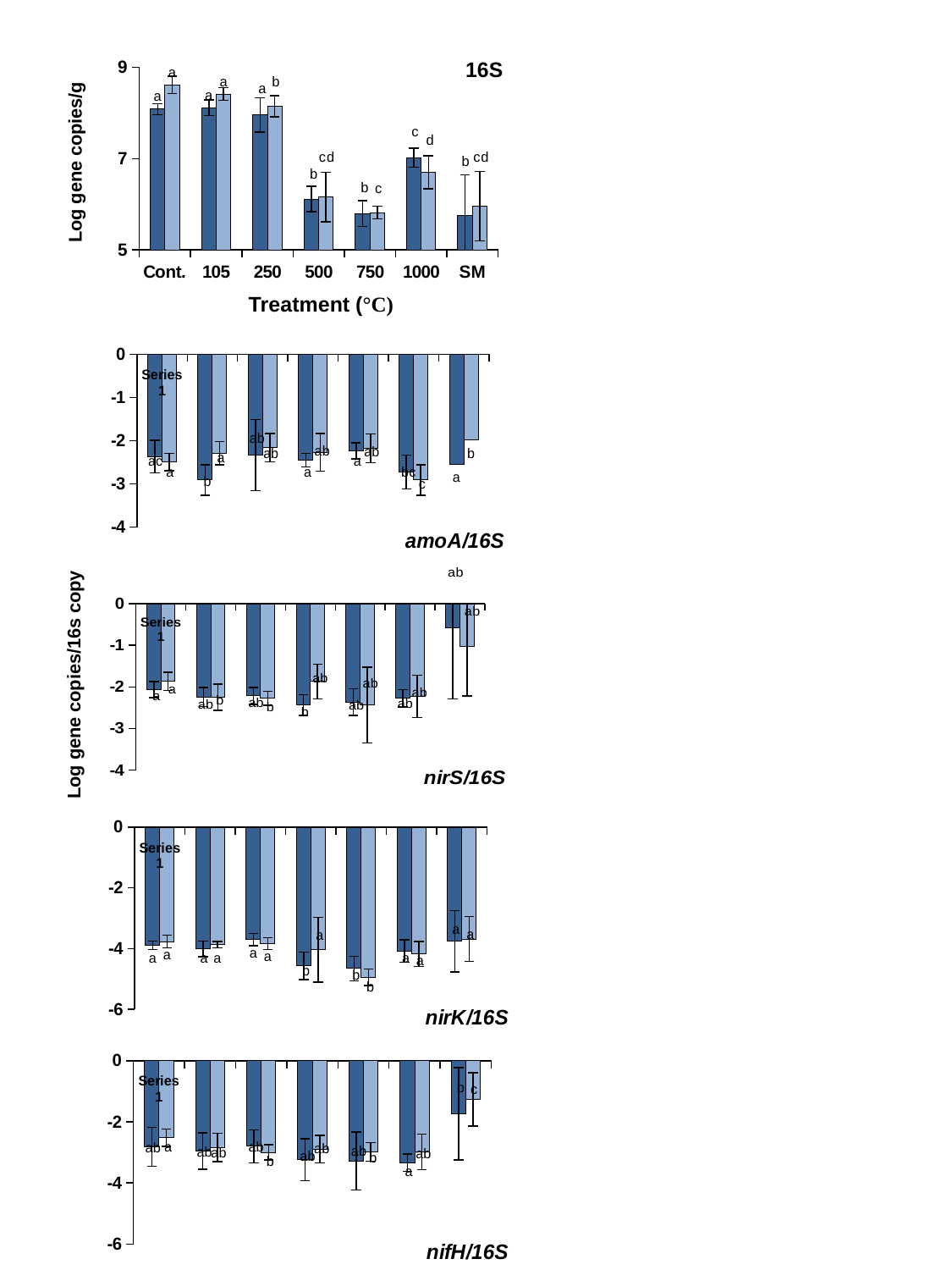
In the nirK/16S chart, is the light-blue bar for 750 greater or less than -4? less In the nirS/16S chart, which treatment has the dark-blue bar closest to 0 (the highest value)? SM In the 16S chart, how many treatment categories are shown on the x axis? 7 In the 16S chart, do the dark-blue bars rise or fall from Cont. to 750? fall How many charts are shown on the slide? 5 What kind of chart is the top chart titled 16S? bar chart In the 16S chart, is the dark-blue bar for Cont. greater or less than 7? greater In the nifH/16S chart, is the dark-blue bar for SM greater or less than -2? greater In the 16S chart, which treatment has the highest light-blue bar? Cont. In the 16S chart, which is higher, the dark-blue bar for 250 or the dark-blue bar for 500? 250 What is the x-axis title of the 16S chart? Treatment (°C)